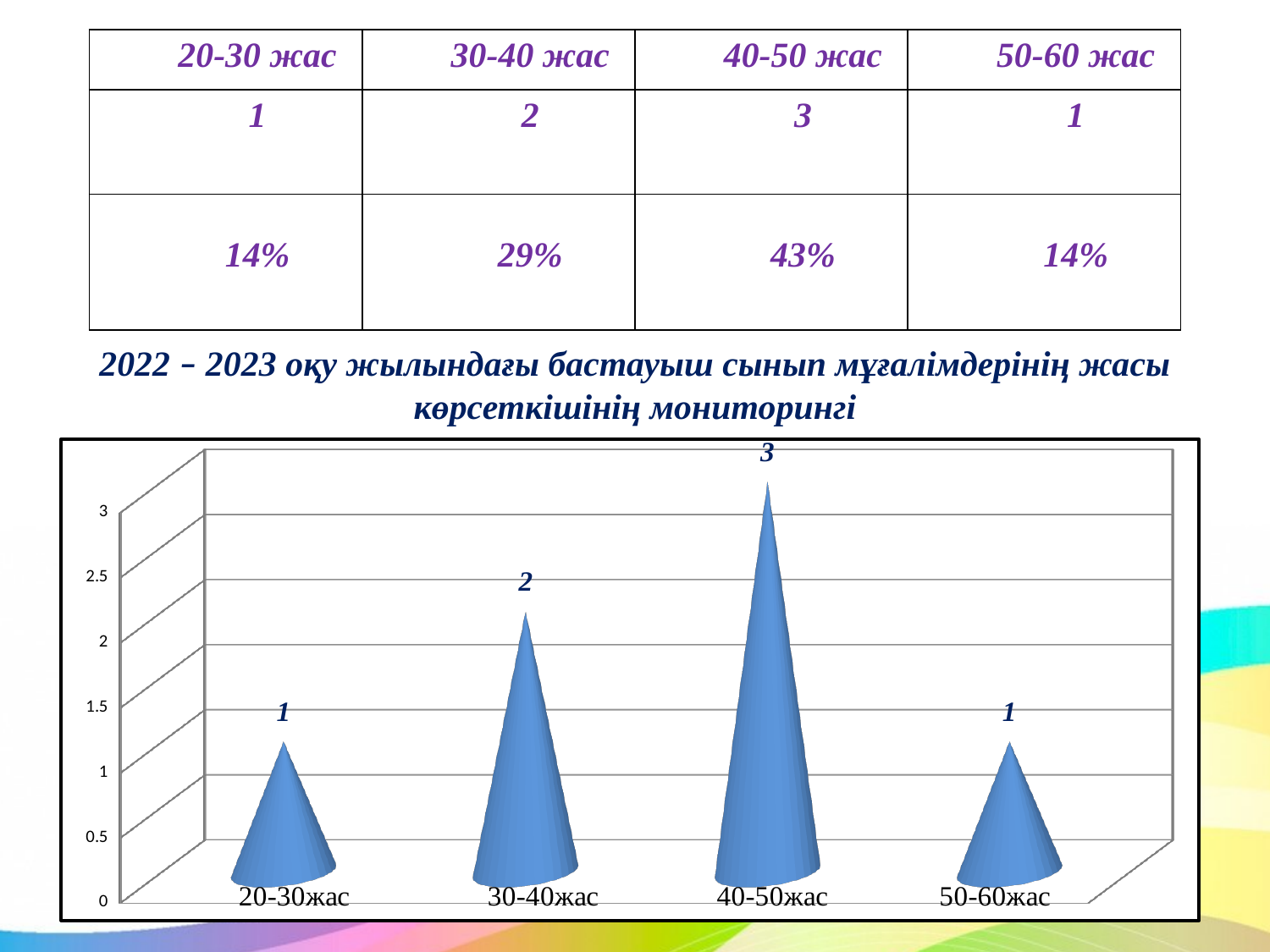
What kind of chart is shown on the slide? bar chart What is the value for the 20-30жас category in the chart? 1 What is the difference between the values for 40-50жас and 20-30жас? 2 What is the difference between the values for 30-40жас and 50-60жас? 1 What is the value for the 40-50жас category in the chart? 3 Which category has the highest value in the chart? 40-50жас What is the value for the 30-40жас category in the chart? 2 Is the value for 40-50жас greater or less than 2.5? greater What is the highest tick value shown on the vertical axis of the chart? 3 How many categories are shown on the x axis of the chart? 4 Which is larger, the value for 30-40жас or the value for 50-60жас? 30-40жас What is the total of all four values plotted in the chart? 7